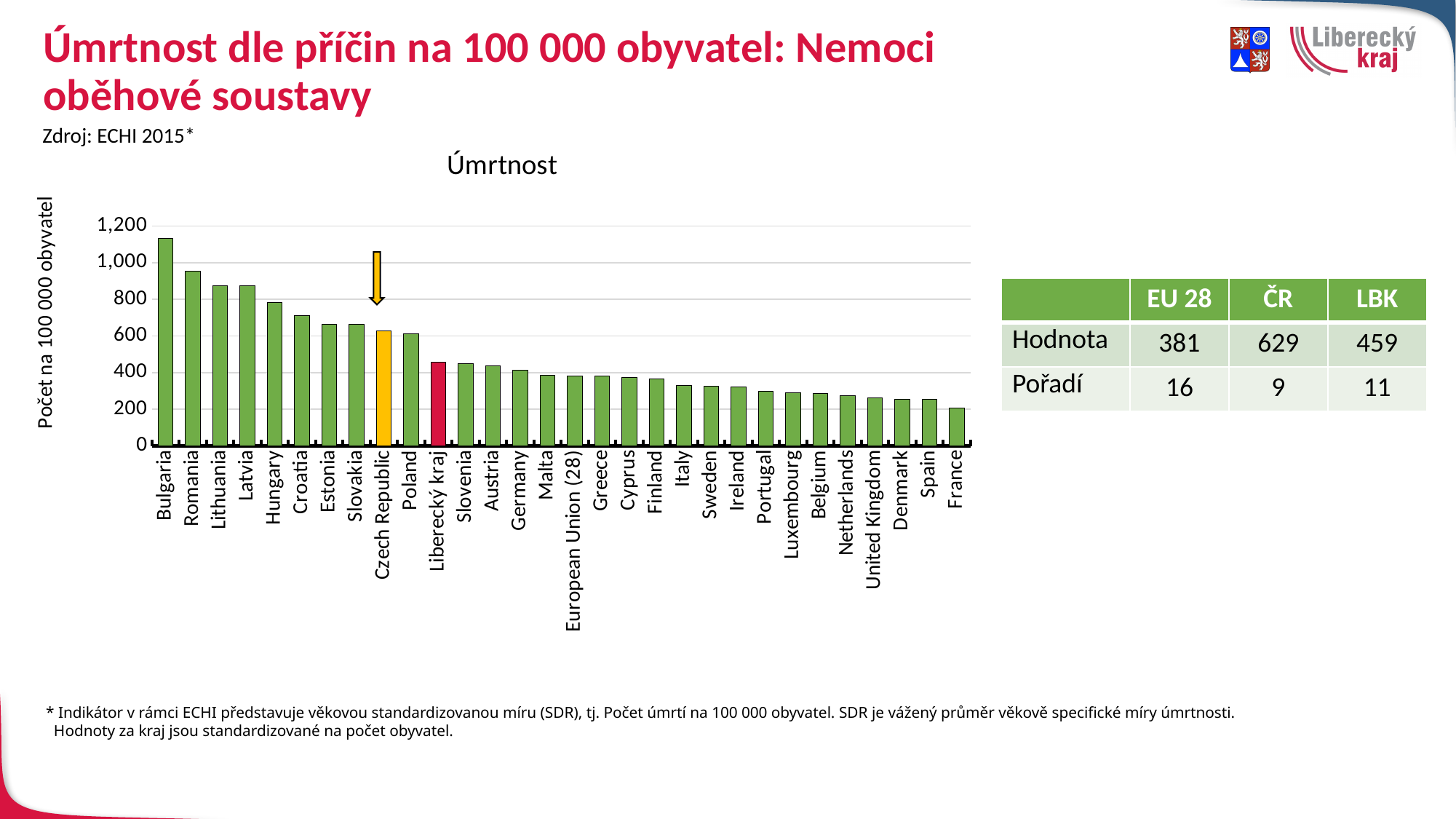
According to the table next to the chart, what is the difference between the value for ČR and the value for LBK? 170 Which category has the lowest value in the chart? France Is the value for Bulgaria greater or less than 1,000? greater What kind of chart is shown on the slide? bar chart Do the values rise or fall moving from left to right along the x axis? fall How many categories (bars) are plotted in the chart? 30 What colour is the bar for Czech Republic in the chart? yellow According to the table next to the chart, what is the value (Hodnota) for ČR? 629 Which is larger, the value for Romania or the value for Poland? Romania Is the value for France greater or less than 400? less Is the value for Romania greater or less than 800? greater Which category has the highest value in the chart? Bulgaria